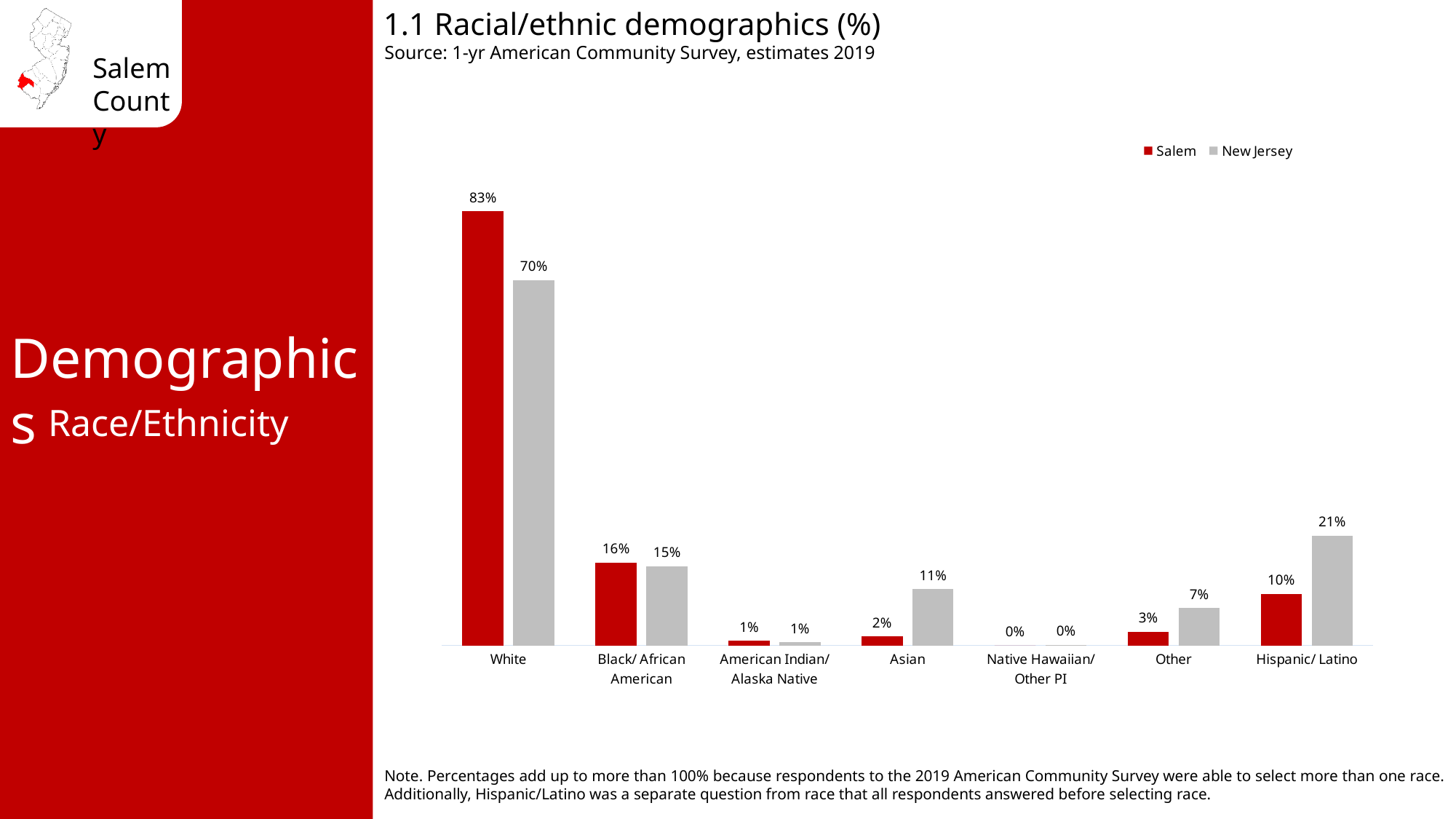
Which category has the lowest New Jersey value? Native Hawaiian/ Other PI How many racial/ethnic categories are shown on the x axis? 7 Which is larger for Asian, the Salem value or the New Jersey value? New Jersey What kind of chart is shown on the slide? Bar chart What is the Salem value for Other? 3% Which category has the highest Salem value? White What is the difference between the New Jersey and Salem values for Hispanic/ Latino? 11% What is the New Jersey value for Asian? 11% What is the New Jersey value for Hispanic/ Latino? 21% What is the Salem value for White? 83% How many series does the legend list? 2 What is the difference between the Salem and New Jersey values for White? 13%